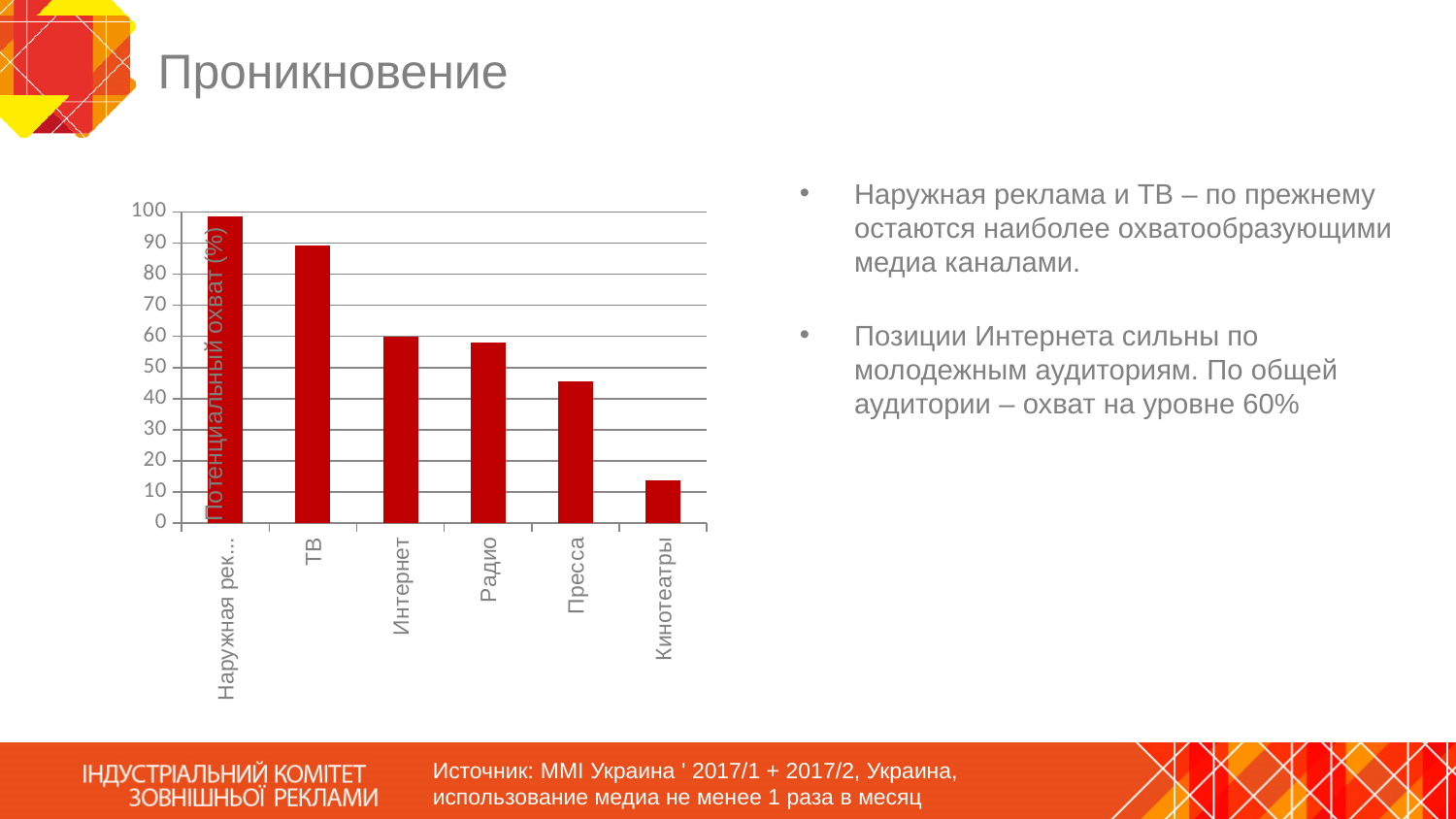
What kind of chart is shown on the slide? bar chart Which category has the lowest value in the chart? Кинотеатры What is the label of the vertical axis of the chart? Потенциальный охват (%) Is the value for ТВ greater or less than 80? greater Which category has the highest value in the chart? Наружная реклама (the first bar) How many categories are plotted in the chart? 6 Which has a larger value, Пресса or Кинотеатры? Пресса Is the value for Кинотеатры greater or less than 20? less Is the value for Пресса greater or less than 50? less Which has a larger value, ТВ or Интернет? ТВ Do the bar values rise or fall from left to right across the categories? fall